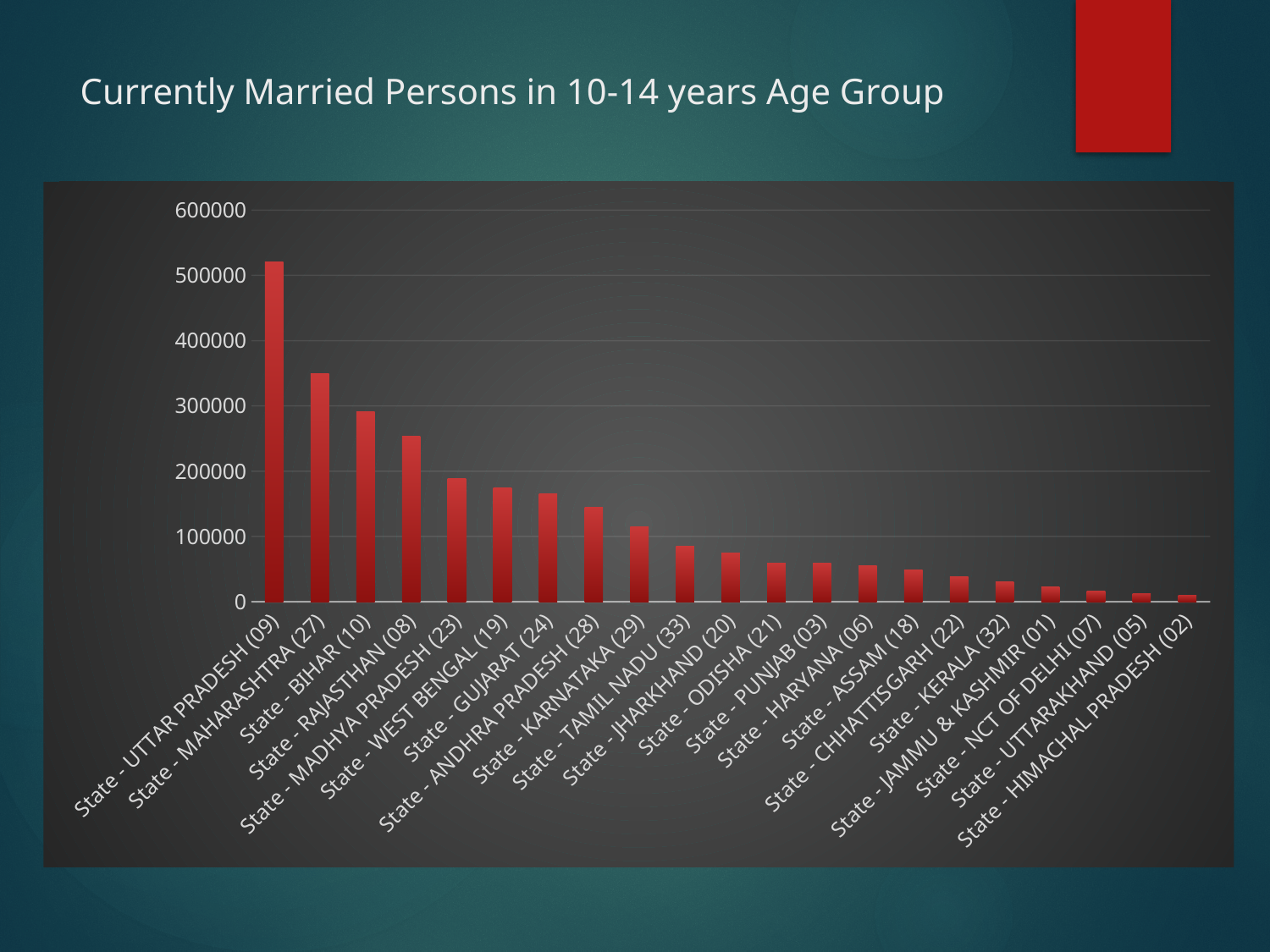
What kind of chart is shown on the slide? bar chart Which has a larger value, State - MAHARASHTRA (27) or State - BIHAR (10)? State - MAHARASHTRA (27) Which state has the lowest value in the chart? State - HIMACHAL PRADESH (02) Is the value for State - MAHARASHTRA (27) greater or less than 300000? greater Is the value for State - WEST BENGAL (19) greater or less than 100000? greater Is the value for State - UTTAR PRADESH (09) greater or less than 500000? greater Which state has the highest value in the chart? State - UTTAR PRADESH (09) How many states are shown on the x axis of the chart? 21 What is the title of the chart? Currently Married Persons in 10-14 years Age Group Do the values rise or fall moving from left to right along the x axis? fall